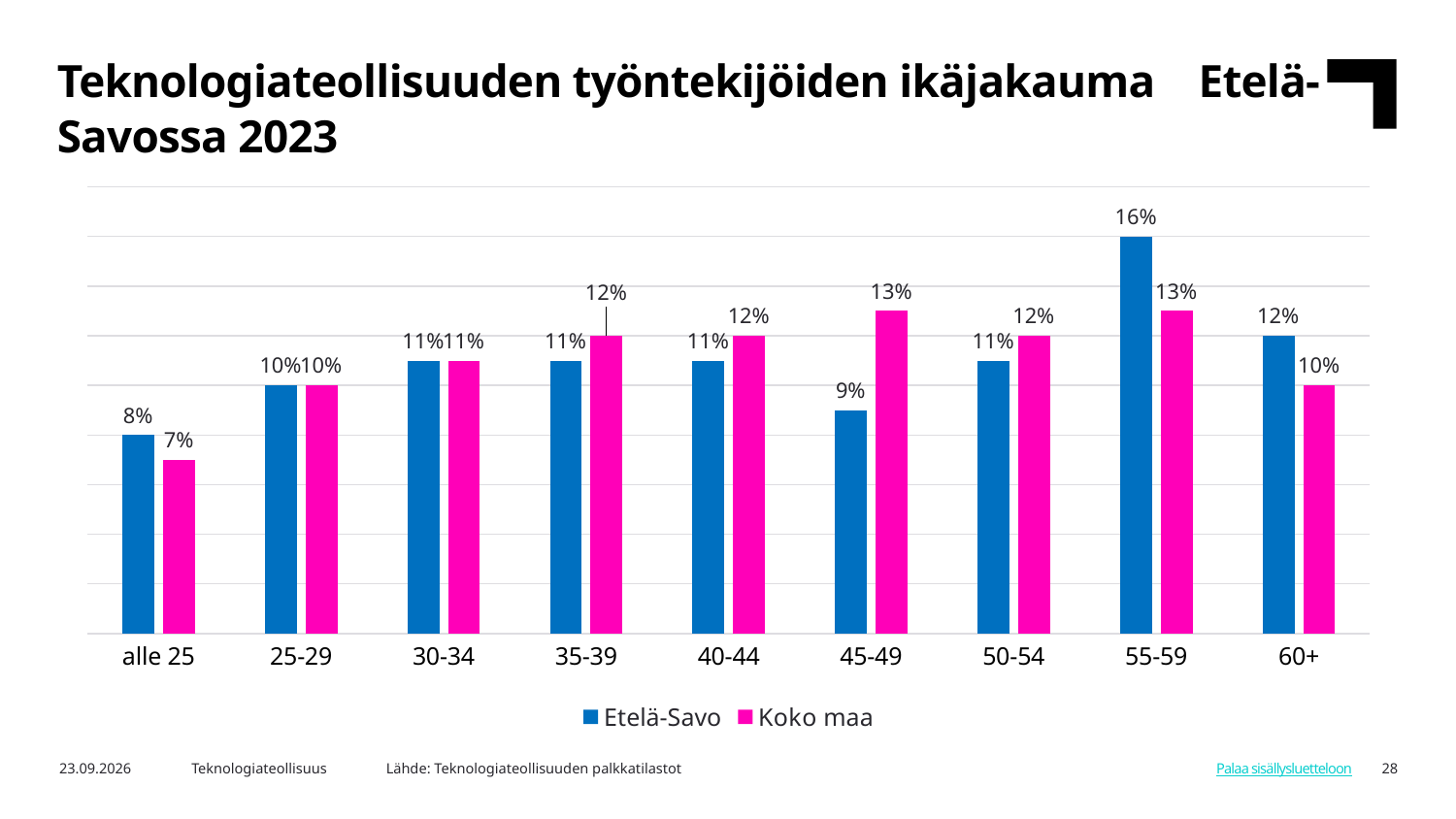
What is the value for Koko maa in the 45-49 age group? 13% Which age group has the lowest value for Koko maa? alle 25 How many series does the legend list? 2 What is the difference between the Etelä-Savo and Koko maa values in the 45-49 age group? 4 percentage points How many age groups are shown on the x axis? 9 Which age group has the highest value for Etelä-Savo? 55-59 What kind of chart is shown on the slide? Bar chart Which colour represents the Koko maa series? Pink What is the value for Etelä-Savo in the 55-59 age group? 16% In the 60+ age group, which series has the larger value, Etelä-Savo or Koko maa? Etelä-Savo What is the value for Etelä-Savo in the alle 25 age group? 8% What is the value for Koko maa in the 60+ age group? 10%